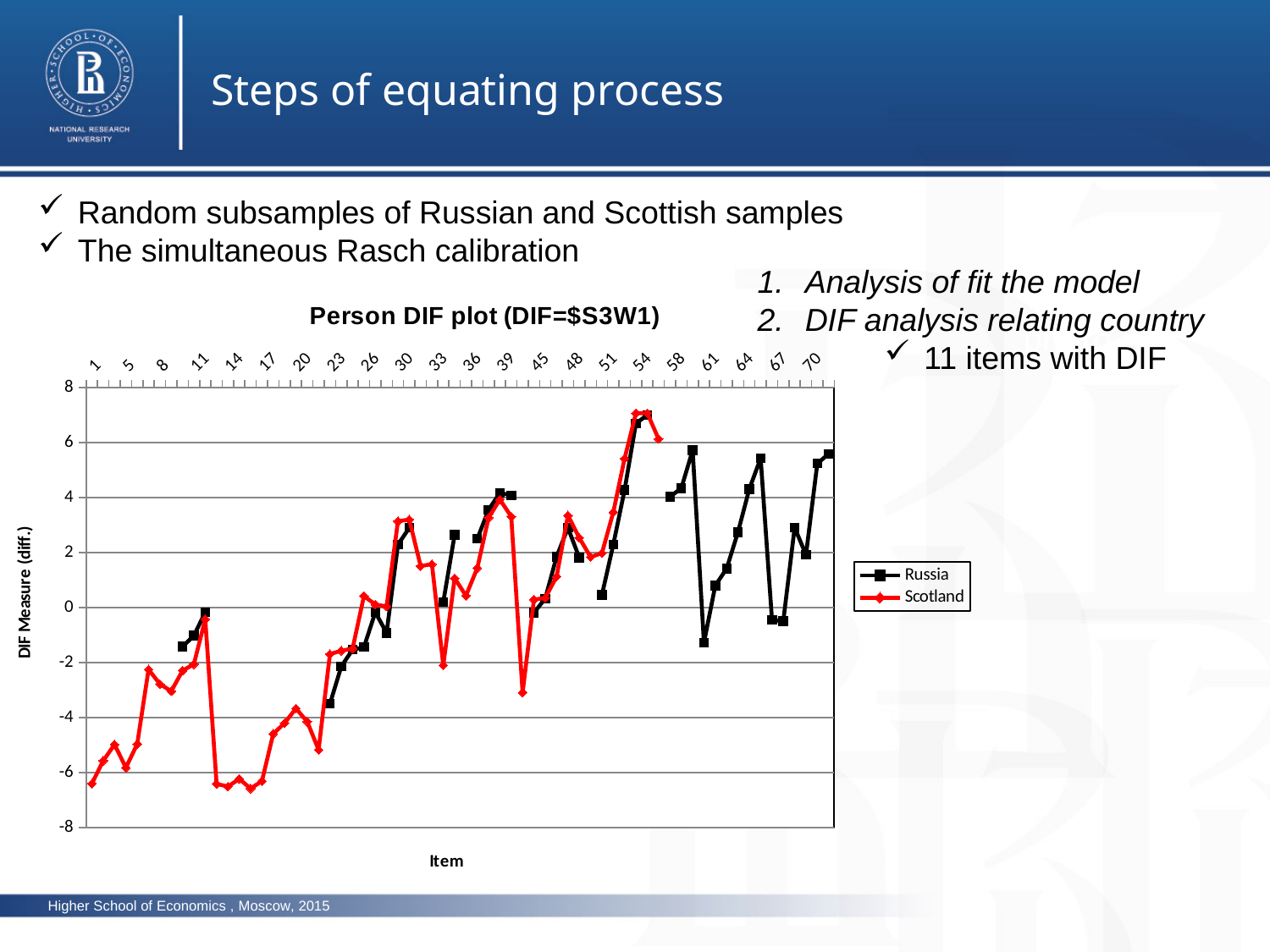
What is the title of the chart? Person DIF plot (DIF=$S3W1) What kind of chart is shown on the slide? line chart Is the Scotland value at item 14 greater or less than -4? less Is the Scotland value at item 39 greater or less than 2? greater Is the Scotland value at item 1 greater or less than -4? less For the Scotland series, which is larger: the value at item 1 or the value at item 54? item 54 Do the Scotland values generally rise or fall from item 1 to item 54? rise How many series does the legend of the Person DIF plot list? 2 Which series is drawn in red in the chart? Scotland Which series reaches the lowest DIF Measure value on the chart? Scotland